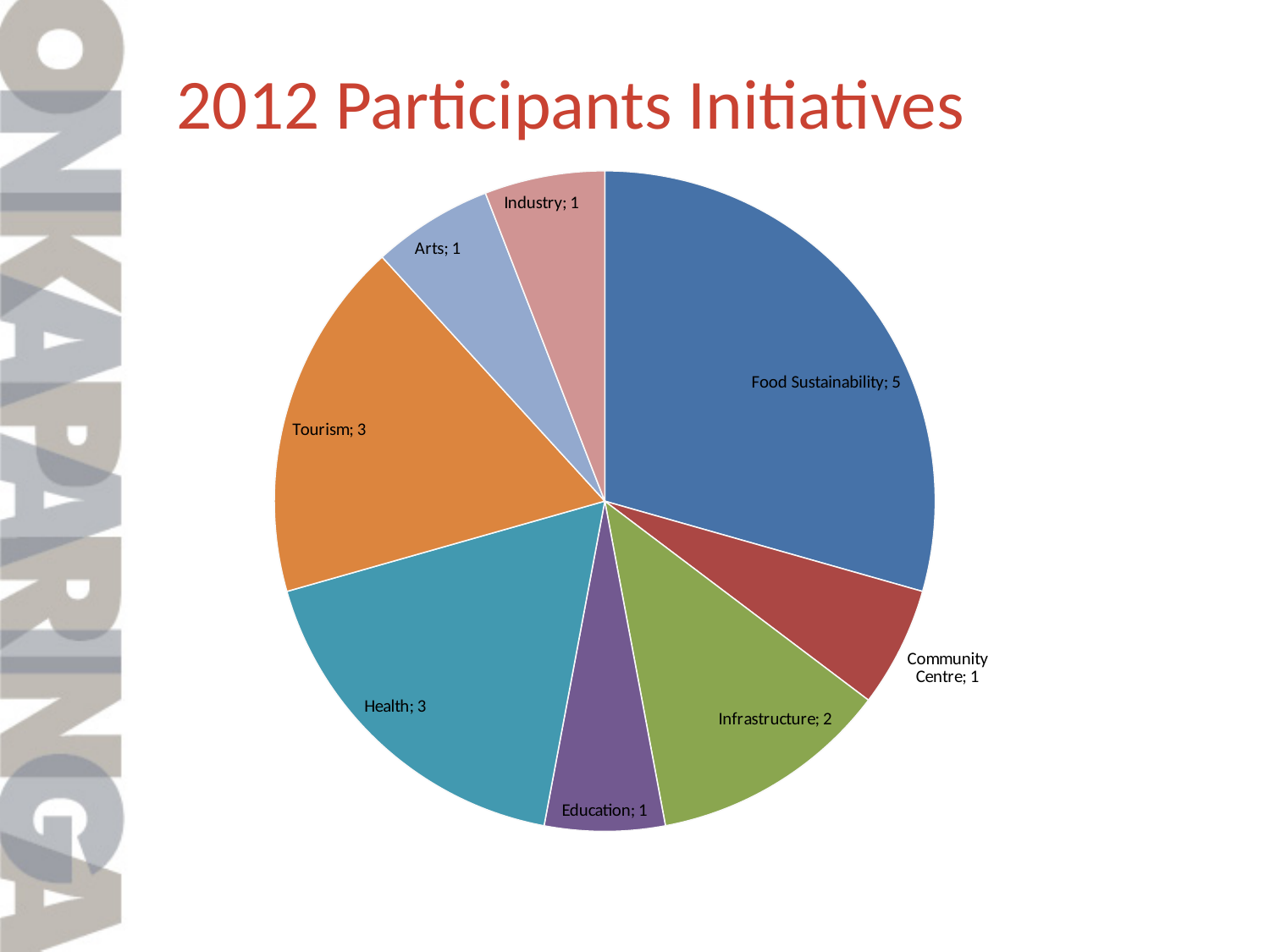
What kind of chart is shown on the slide? pie chart What is the value for Infrastructure? 2 What is the difference between the values for Food Sustainability and Health? 2 What is the title of the chart? 2012 Participants Initiatives What is the value for Tourism? 3 What is the total of all the values in the pie chart? 17 How many categories have a value of 1? 4 What is the difference between the values for Tourism and Infrastructure? 1 How many slices does the pie chart have? 8 Which is larger, Infrastructure or Education? Infrastructure What is the value for Food Sustainability? 5 Which category has the largest slice? Food Sustainability